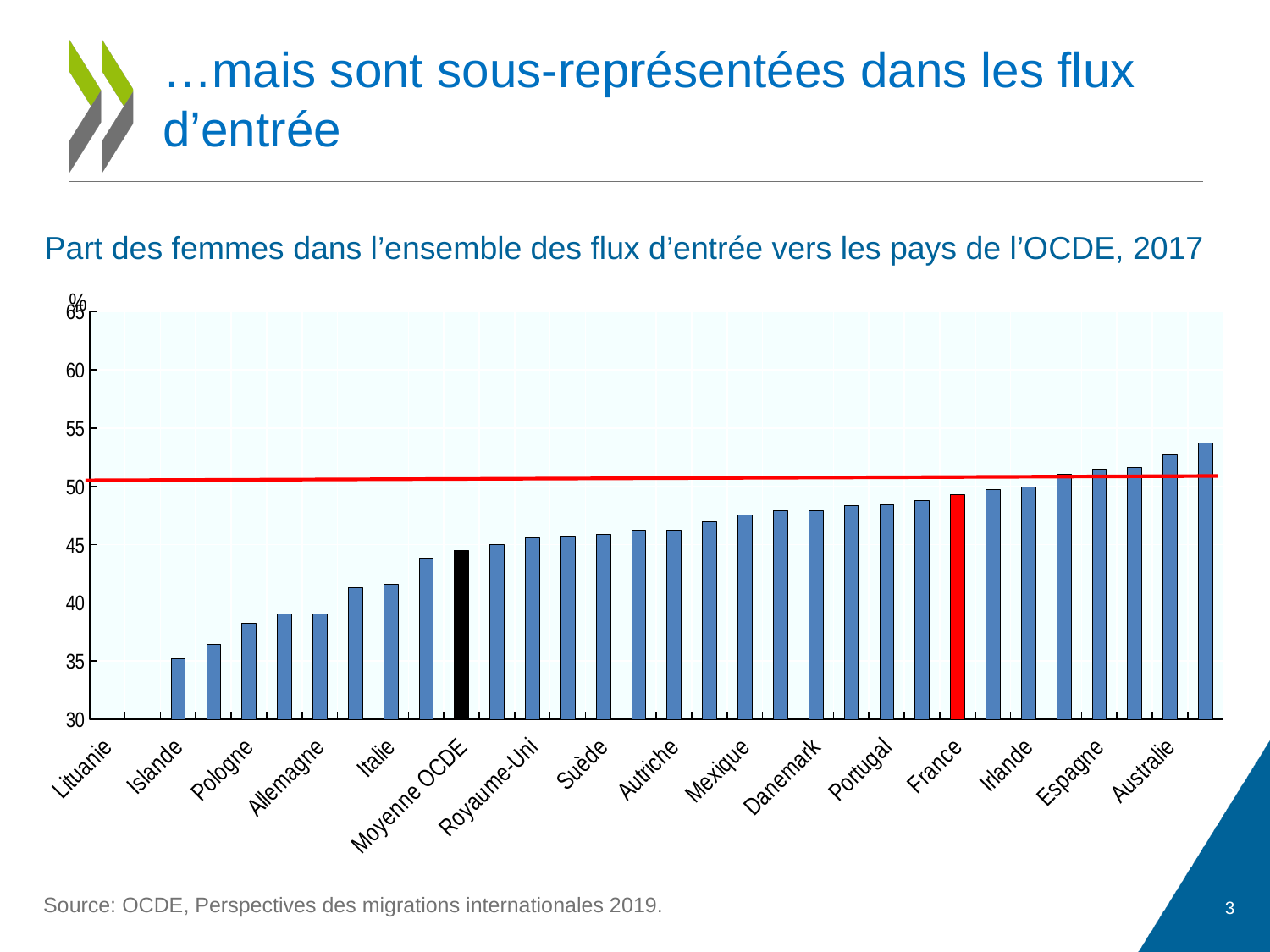
What colour is the bar for France? red Which has the larger value, Pologne or Espagne? Espagne Do the bar values rise or fall from left to right along the x axis? rise What kind of chart is shown on the slide? bar chart Which has the larger value, Australie or Islande? Australie Is the value for Italie greater or less than 40? greater Is the value for Islande greater or less than 40? less What is the title of the chart? Part des femmes dans l'ensemble des flux d'entrée vers les pays de l'OCDE, 2017 Is the value for France greater or less than 45? greater Which has the larger value, France or Moyenne OCDE? France